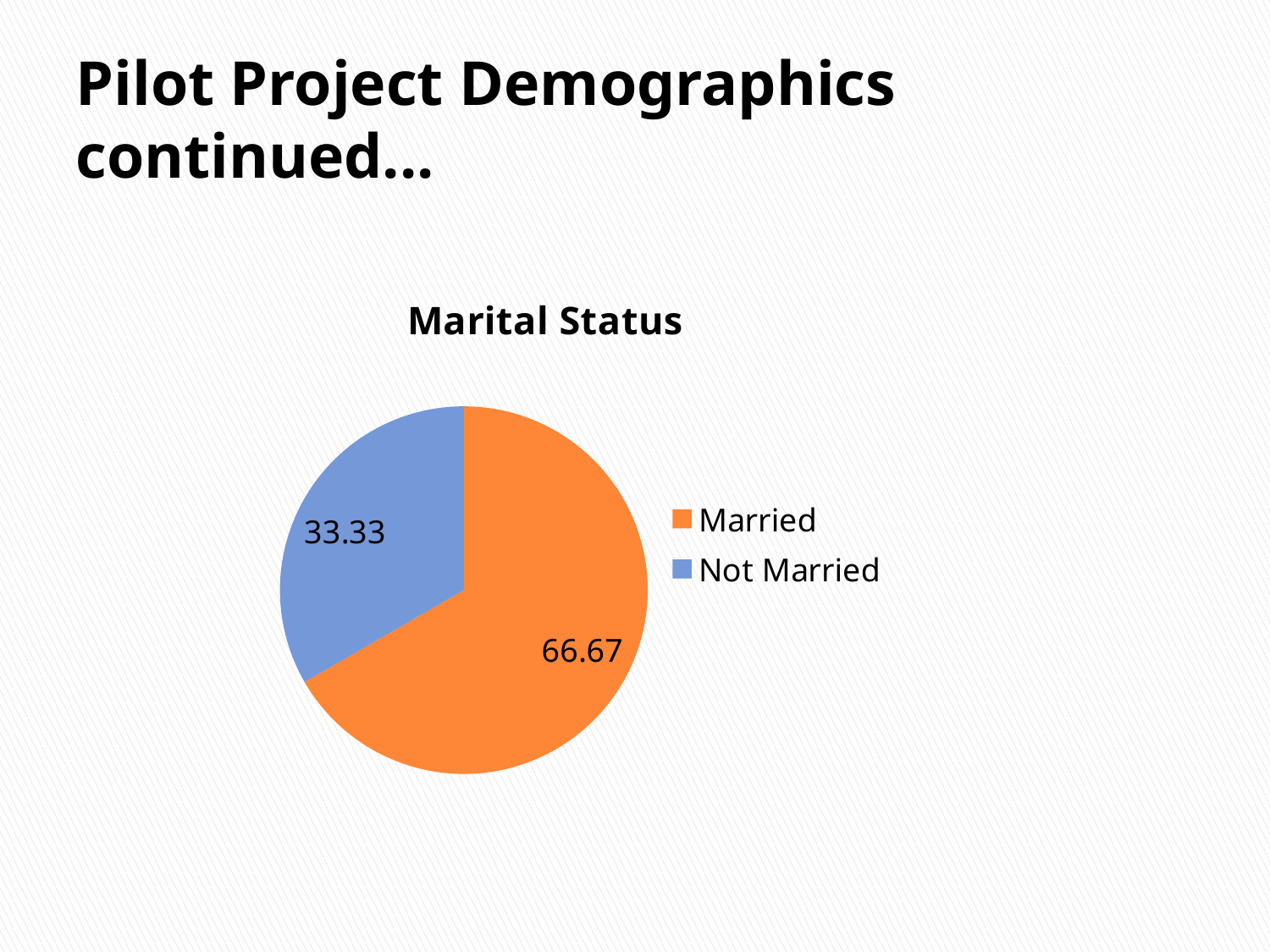
What colour is the Married slice in the Marital Status pie chart? Orange What kind of chart is used to show Marital Status? Pie chart How many categories are shown in the Marital Status pie chart? 2 What is the value shown for Not Married in the Marital Status pie chart? 33.33 What is the difference between the Married and Not Married values in the Marital Status chart? 33.34 Which is larger in the Marital Status chart, Married or Not Married? Married What is the title of the chart on the slide? Marital Status Which category has the largest slice in the Marital Status pie chart? Married Which category has the smallest slice in the Marital Status pie chart? Not Married What is the total of the two values shown in the Marital Status pie chart? 100 What is the value shown for Married in the Marital Status pie chart? 66.67